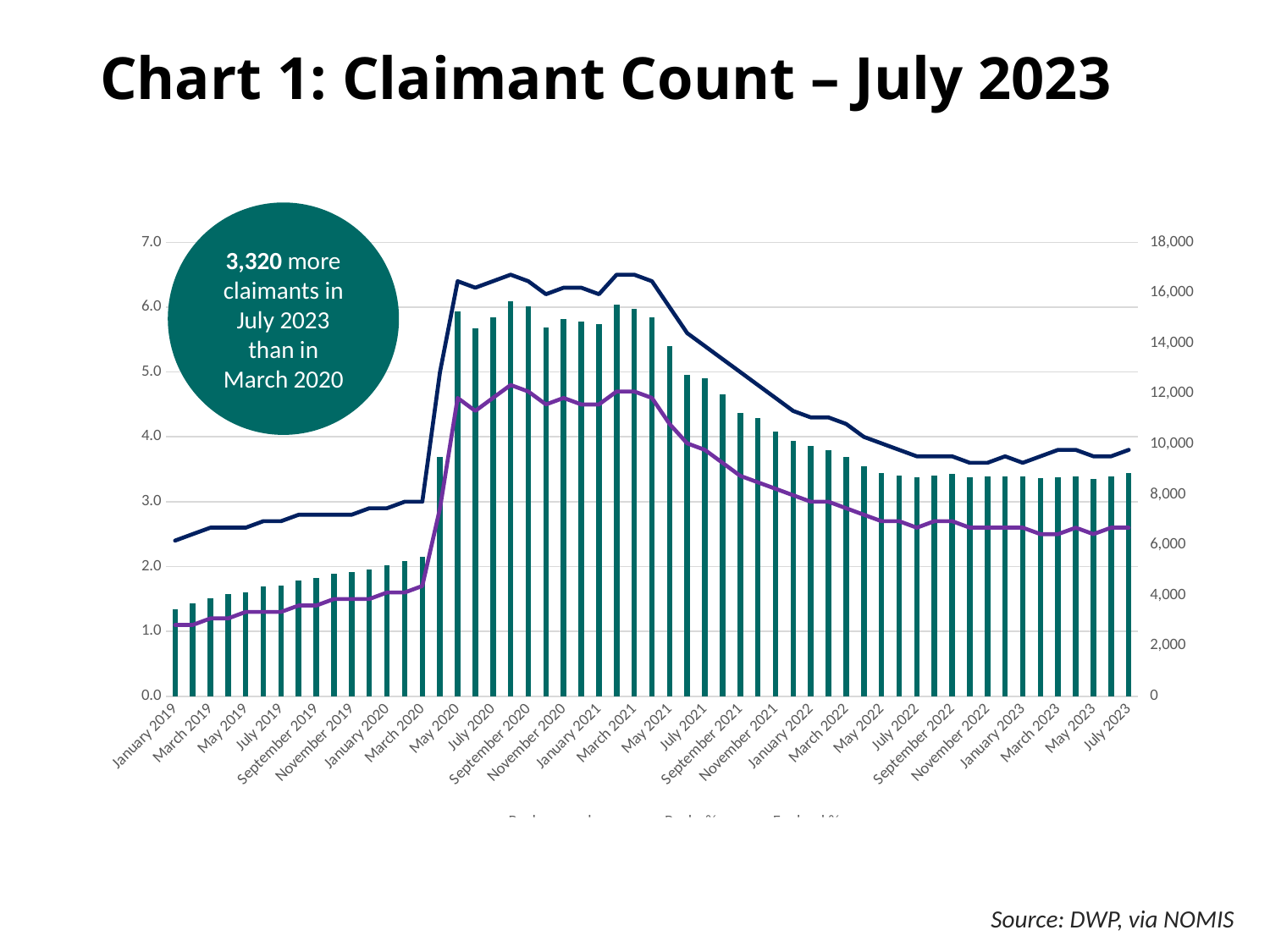
Which is larger, the bar for September 2020 or the bar for July 2023? September 2020 According to the callout on the chart, how many more claimants were there in July 2023 than in March 2020? 3,320 Is the bar value for March 2020 greater or less than 6,000 on the right-hand axis? less Do the bars rise or fall between September 2020 and July 2023? fall What is the title of the chart? Chart 1: Claimant Count – July 2023 Do the bars rise or fall between January 2019 and March 2020? rise Which month has the lowest bar on the chart? January 2019 Is the bar value for January 2019 greater or less than 4,000 on the right-hand axis? less Is the bar value for July 2023 greater or less than 10,000 on the right-hand axis? less What kind of chart is shown on the slide? A combined bar and line chart